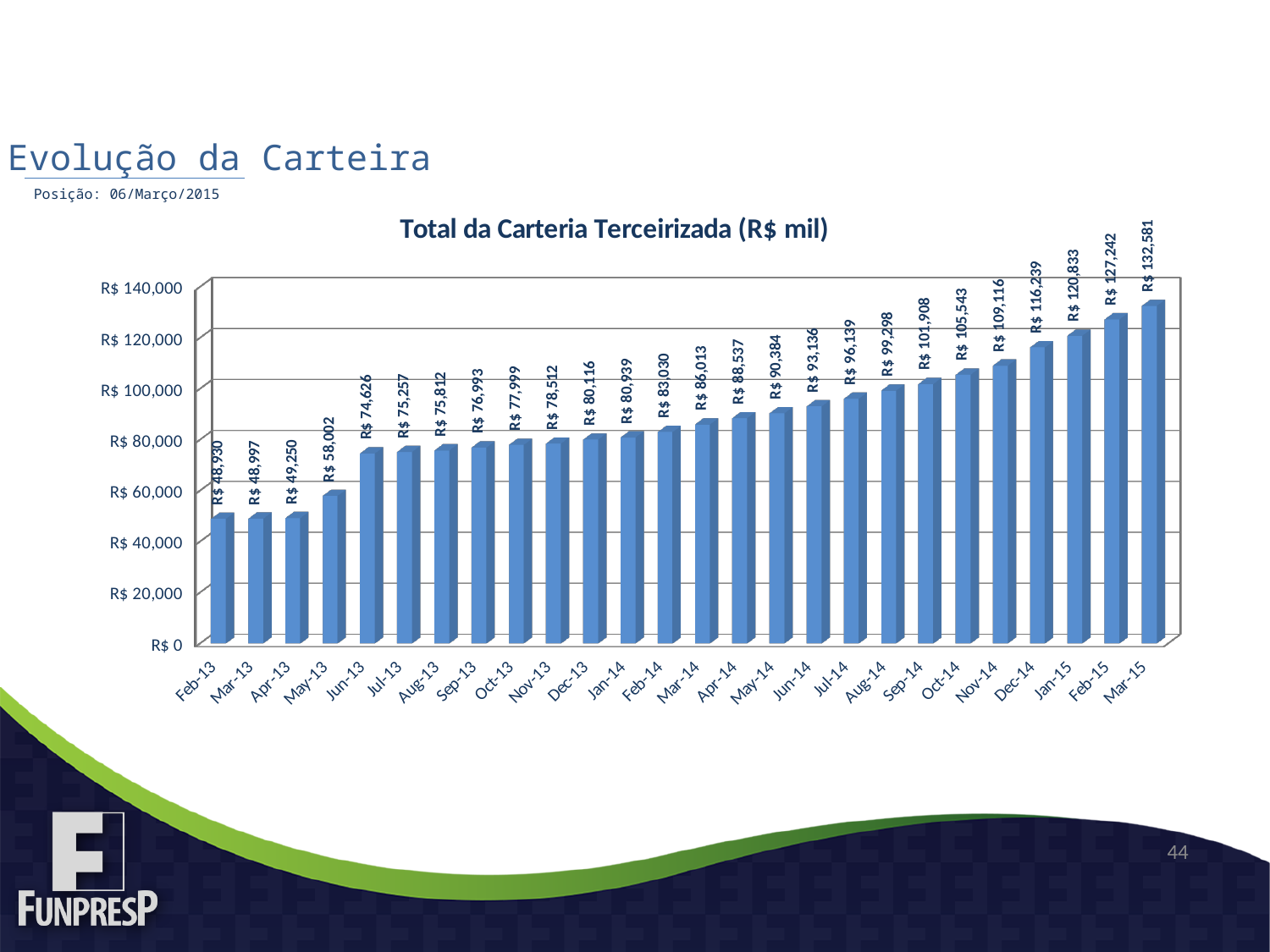
What type of chart is shown on the slide? bar chart What is the value for Feb-13? R$ 48,930 What is the title of the chart? Total da Carteria Terceirizada (R$ mil) Which is larger, the value for Oct-14 or the value for Aug-14? Oct-14 Which month has the highest value? Mar-15 What is the difference between the values for Jun-13 and May-13? R$ 16,624 What is the value for Jun-13? R$ 74,626 What is the value for Dec-14? R$ 116,239 Which month has the lowest value? Feb-13 How many months are shown on the x axis? 26 What is the value for Mar-15? R$ 132,581 What is the difference between the values for Mar-15 and Feb-13? R$ 83,651